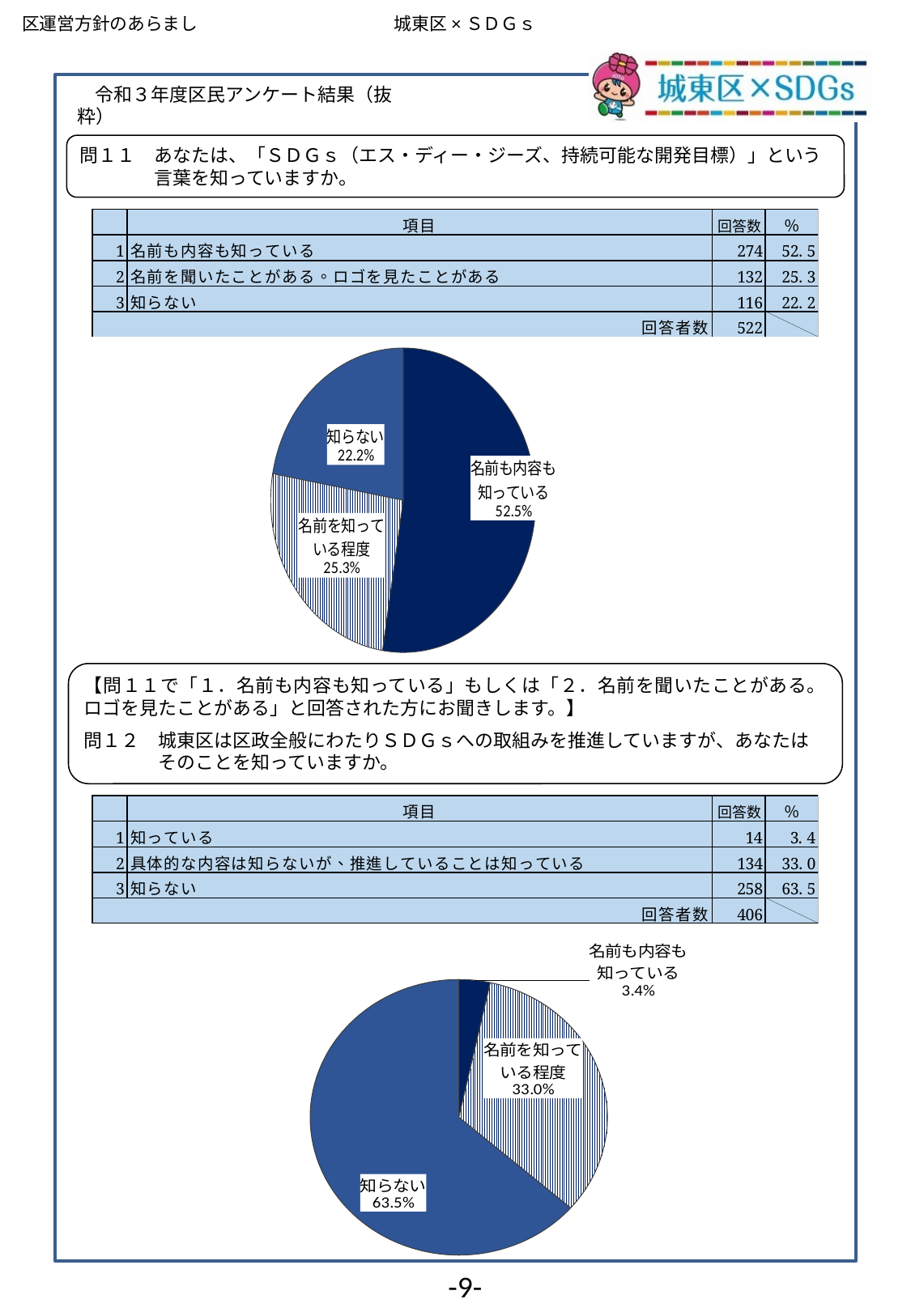
In the upper pie chart, what share is labelled for 知らない? 22.2% In the upper pie chart, what share is labelled for 名前を知っている程度? 25.3% In the upper pie chart, which slice is the largest? 名前も内容も知っている In the upper pie chart, what is the difference in percentage points between 名前も内容も知っている and 知らない? 30.3 What kind of chart is the upper chart on the slide? Pie chart How many slices does the lower pie chart have? 3 In the lower pie chart, what share is labelled for 名前も内容も知っている? 3.4% In the upper pie chart, what share is labelled for 名前も内容も知っている? 52.5% In the upper pie chart, which slice is the smallest? 知らない In the lower pie chart, which slice is the largest? 知らない In the lower pie chart, which is larger, 名前を知っている程度 or 名前も内容も知っている? 名前を知っている程度 In the lower pie chart, what share is labelled for 知らない? 63.5%